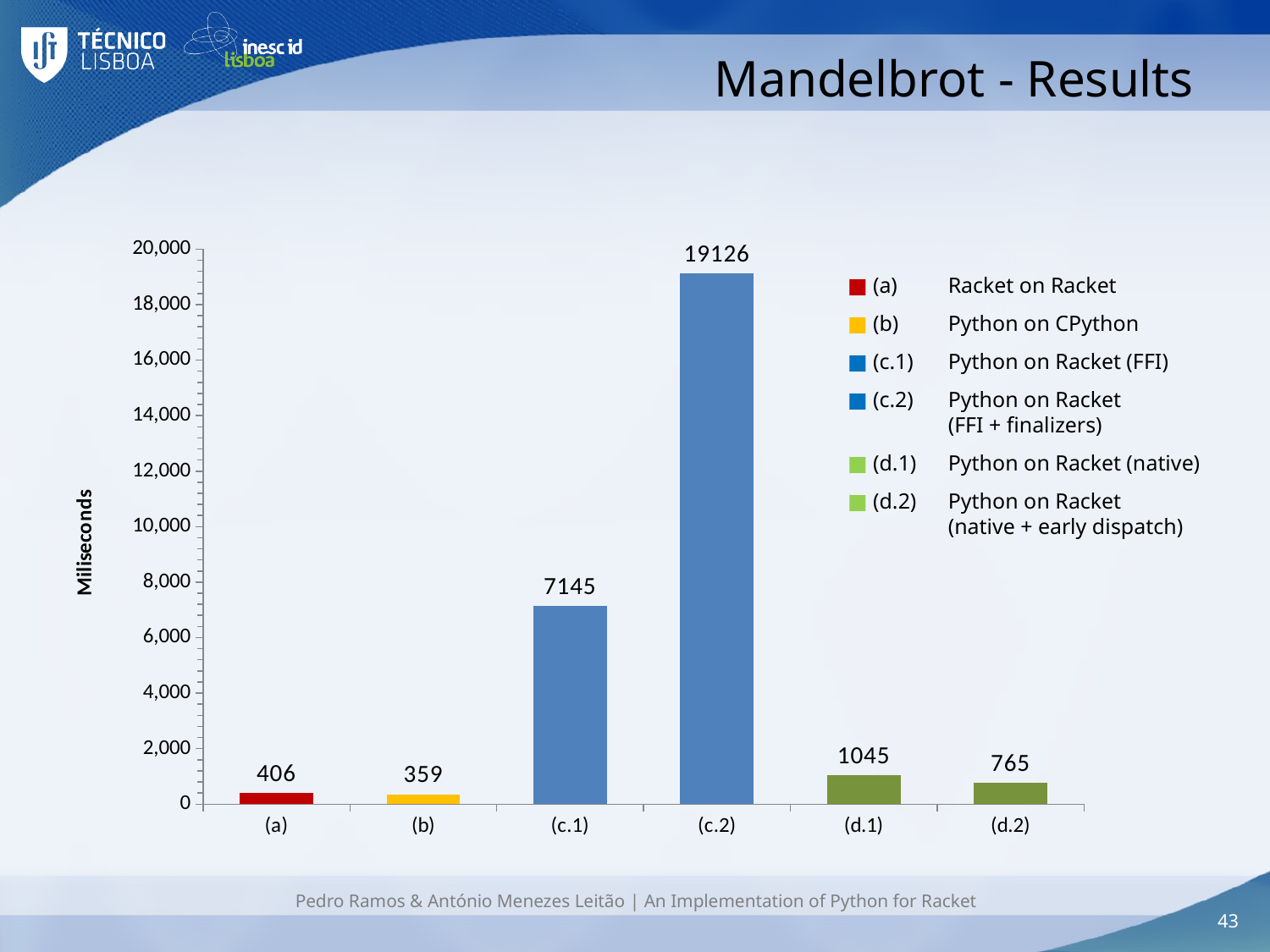
Is the value for (c.1) greater or less than 8,000? less Which category has the highest value in the Mandelbrot results chart? (c.2) What is the difference between the values for (c.2) and (c.1)? 11981 Which is larger, the value for (a) or the value for (b)? (a) How many categories are shown on the x axis of the chart? 6 Which category has the lowest value in the Mandelbrot results chart? (b) According to the legend, what does (d.2) stand for? Python on Racket (native + early dispatch) What kind of chart is shown on the slide? bar chart What is the value for (a) in the Mandelbrot results chart? 406 What is the value for (c.2) in the Mandelbrot results chart? 19126 What is the difference between the values for (d.1) and (d.2)? 280 What is the value for (d.1) in the Mandelbrot results chart? 1045